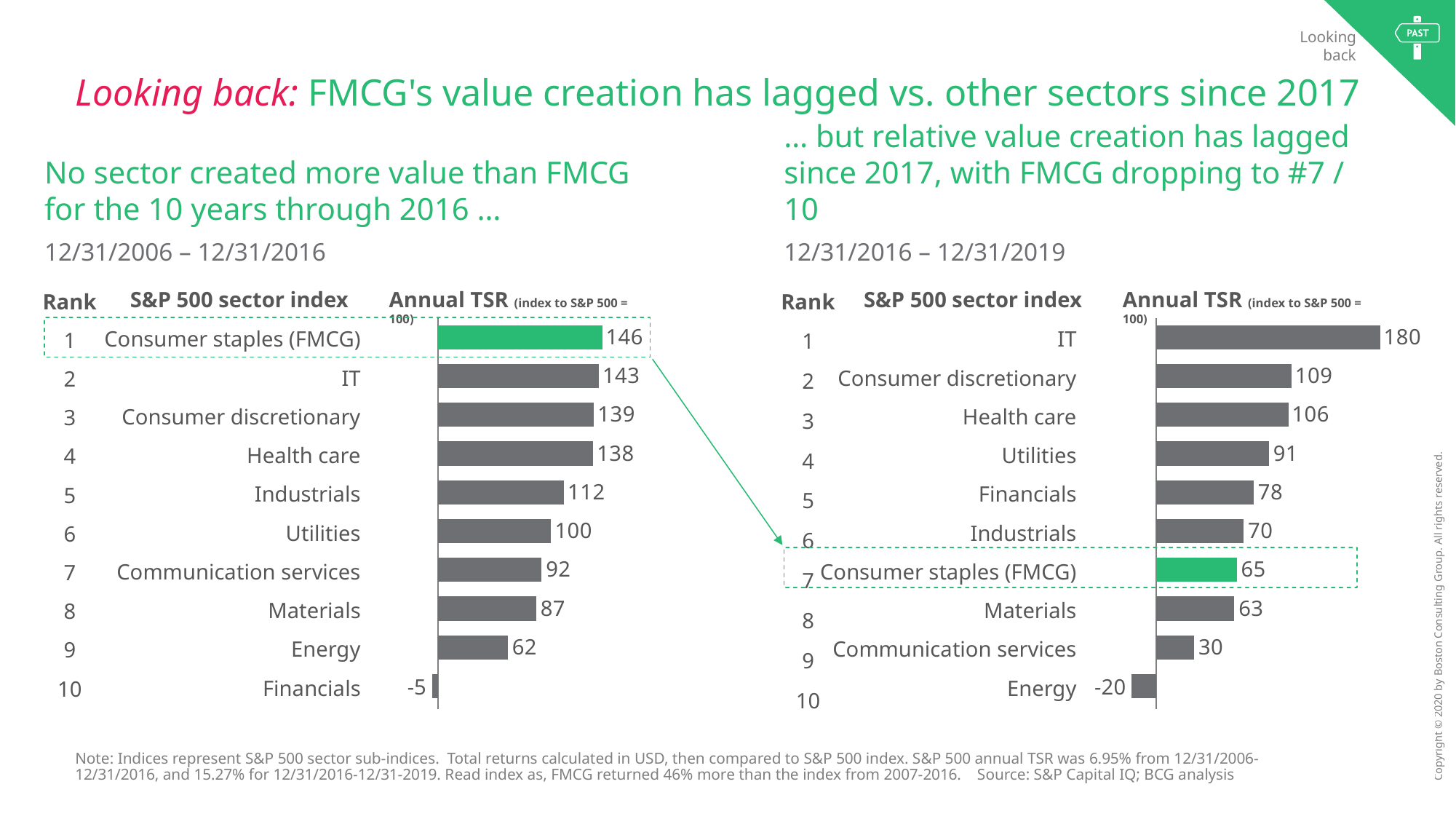
In the right chart (12/31/2016 – 12/31/2019), which sector has the lowest annual TSR? Energy In the right chart (12/31/2016 – 12/31/2019), which sector has the highest annual TSR? IT In the left chart (12/31/2006 – 12/31/2016), which sector has the lowest annual TSR? Financials In the left chart (12/31/2006 – 12/31/2016), what is the annual TSR value for Energy? 62 In the left chart (12/31/2006 – 12/31/2016), what is the difference between the annual TSR of Consumer staples (FMCG) and IT? 3 In the right chart (12/31/2016 – 12/31/2019), what is the annual TSR value for Consumer staples (FMCG)? 65 What type of chart is used on the right side of the slide (12/31/2016 – 12/31/2019)? Bar chart In the left chart (12/31/2006 – 12/31/2016), which has a higher annual TSR, Industrials or Utilities? Industrials In the right chart (12/31/2016 – 12/31/2019), what is the difference between the annual TSR of IT and Consumer discretionary? 71 In the right chart (12/31/2016 – 12/31/2019), which has a higher annual TSR, Financials or Industrials? Financials In the left chart (12/31/2006 – 12/31/2016), what is the annual TSR value for Consumer staples (FMCG)? 146 How many sectors are shown in the left chart (12/31/2006 – 12/31/2016)? 10